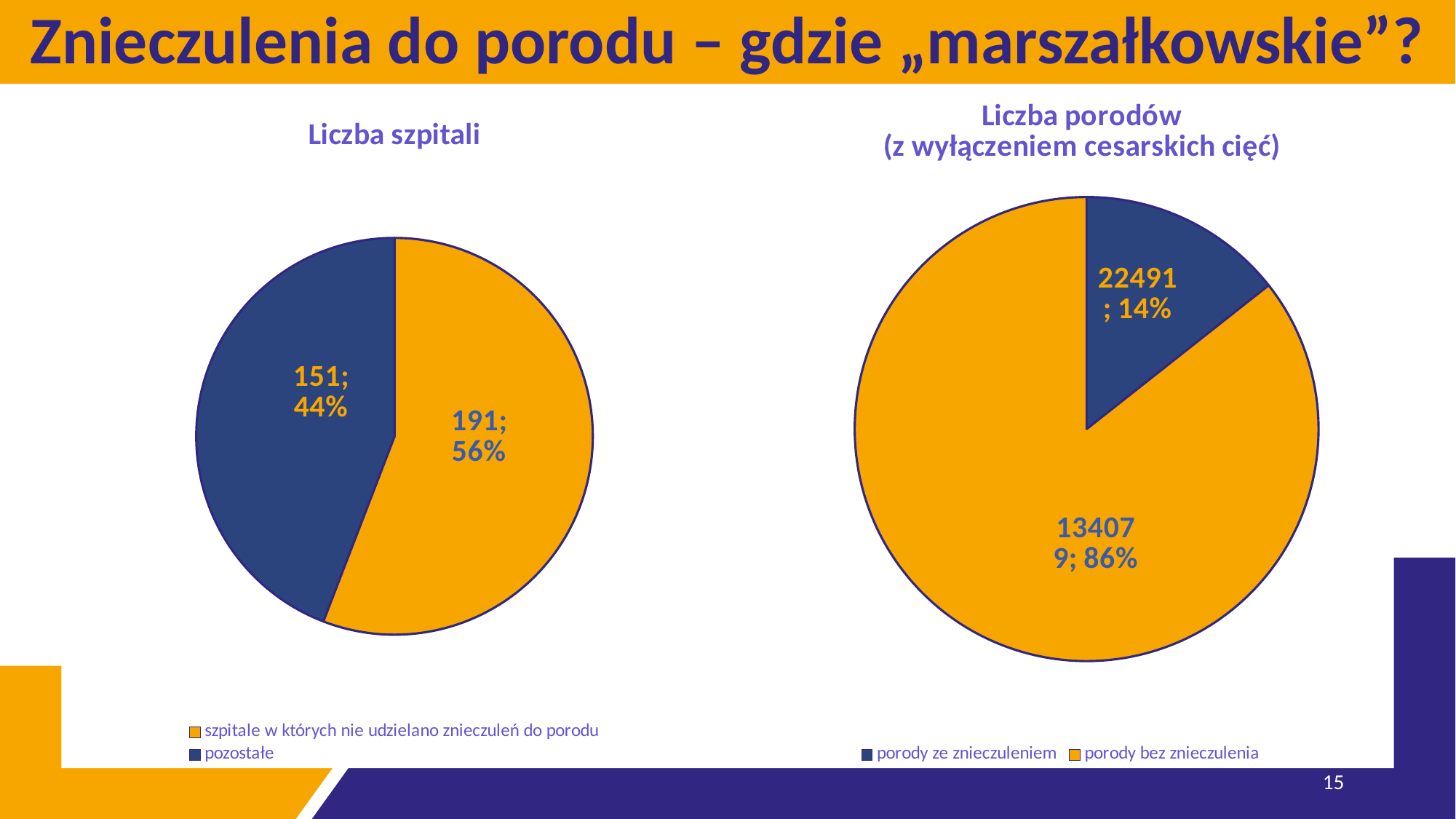
In the "Liczba szpitali" chart, what is the value for "szpitale w których nie udzielano znieczuleń do porodu"? 191 In the "Liczba szpitali" chart, what is the difference between the two slices? 40 In the "Liczba porodów" chart, which slice is the smallest? porody ze znieczuleniem In the "Liczba szpitali" chart, what is the total of the two slices? 342 How many slices does the "Liczba porodów" chart have? 2 In the "Liczba szpitali" chart, what share of the pie is "pozostałe"? 44% In the "Liczba porodów" chart, what share of the pie is "porody bez znieczulenia"? 86% In the "Liczba porodów" chart, what is the value for "porody ze znieczuleniem"? 22491 In the "Liczba porodów" chart, what colour is the "porody ze znieczuleniem" slice? blue In the "Liczba szpitali" chart, what is the value for "pozostałe"? 151 In the "Liczba szpitali" chart, which slice is larger: "pozostałe" or "szpitale w których nie udzielano znieczuleń do porodu"? szpitale w których nie udzielano znieczuleń do porodu What type of chart is the "Liczba szpitali" chart? pie chart